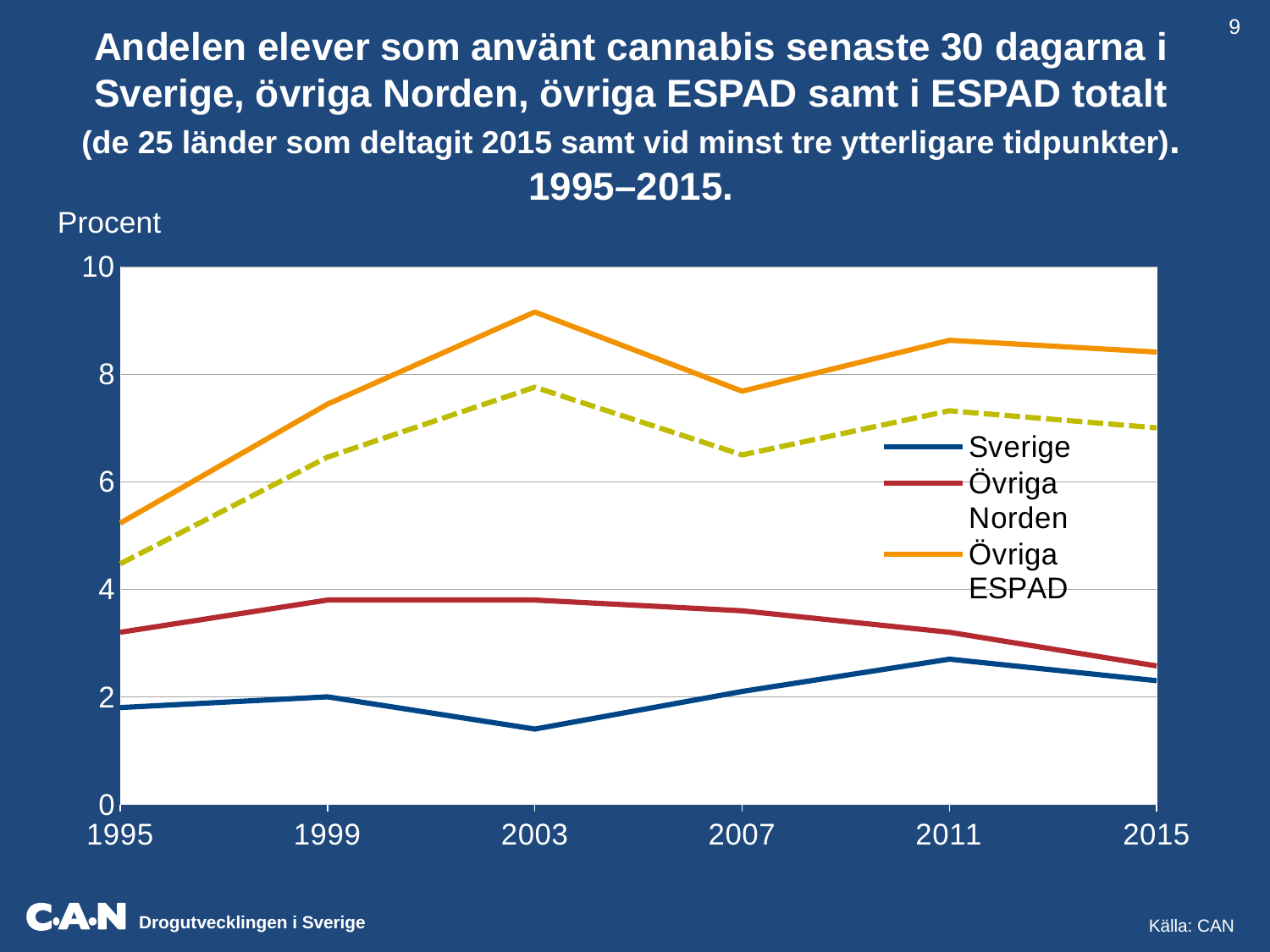
In which year does the Övriga ESPAD line reach its highest value? 2003 Does the Övriga Norden line rise or fall between 1999 and 2015? fall How many series does the legend list? 3 Which series has the higher value in 2015, Sverige or Övriga Norden? Övriga Norden Is the value for Sverige in 2003 greater or less than 2? less Is the value for Övriga ESPAD in 2003 greater or less than 8? greater What kind of chart is shown on the slide? line chart In which year does the Sverige line reach its lowest value? 2003 Is the value for Övriga Norden in 1999 greater or less than 4? less What is the label on the y axis of the chart? Procent In which year does the Sverige line reach its highest value? 2011 How many years are marked on the x axis? 6